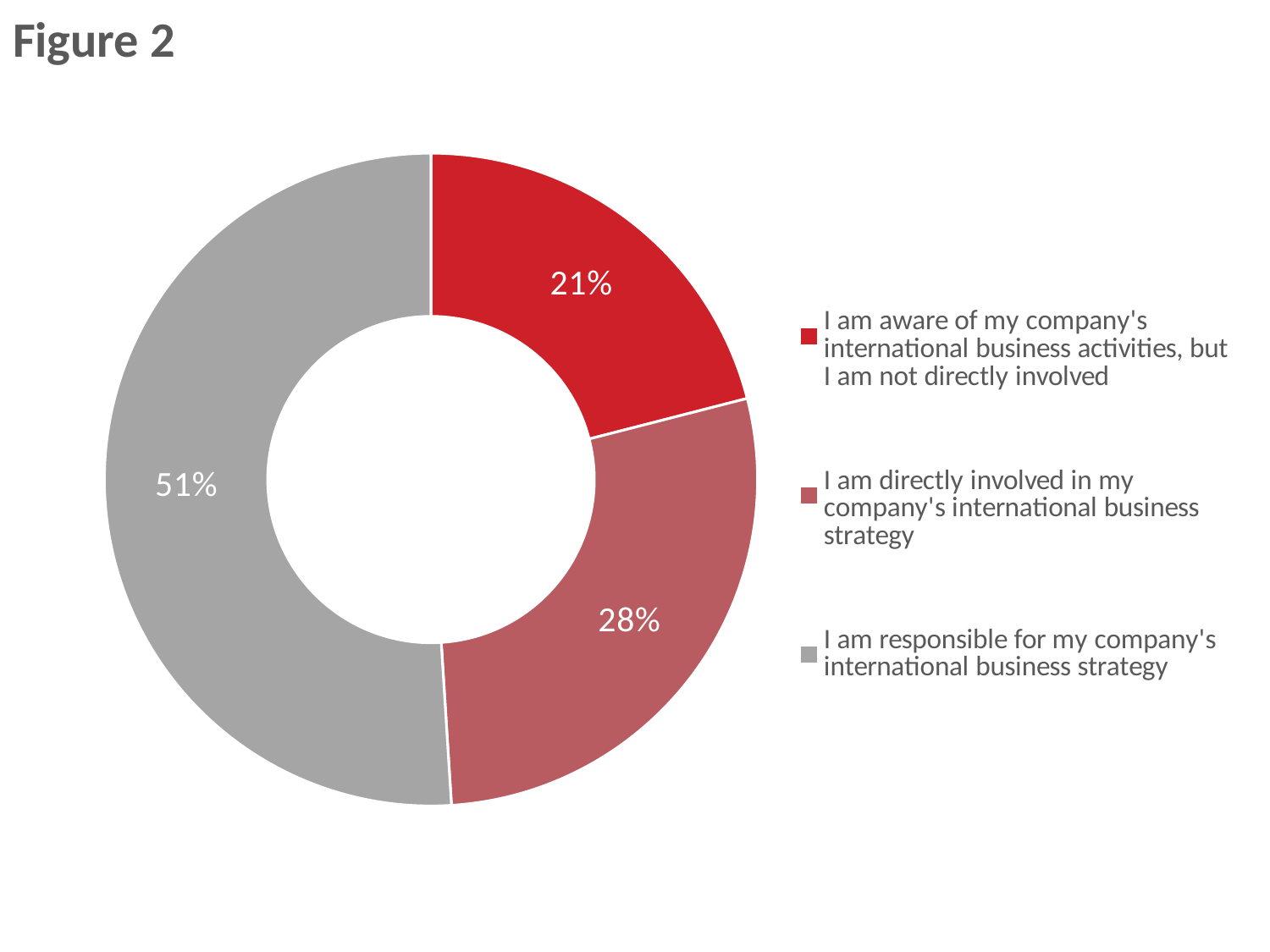
Which share is larger: 'directly involved in my company's international business strategy' or 'aware of my company's international business activities, but not directly involved'? I am directly involved in my company's international business strategy What is the difference in percentage points between the 'directly involved' and 'aware but not directly involved' responses? 7 What percentage of respondents said they are aware of their company's international business activities but not directly involved? 21% What is the difference in percentage points between the 'responsible' and 'directly involved' responses? 23 How many categories are shown in the chart? 3 What colour is the slice for 'I am responsible for my company's international business strategy'? Grey What percentage of respondents said they are directly involved in their company's international business strategy? 28% What kind of chart is shown on the slide? Doughnut (pie) chart Which response has the smallest share of the chart? I am aware of my company's international business activities, but I am not directly involved Which response has the largest share of the chart? I am responsible for my company's international business strategy What percentage of respondents said they are responsible for their company's international business strategy? 51% What is the title of the slide? Figure 2